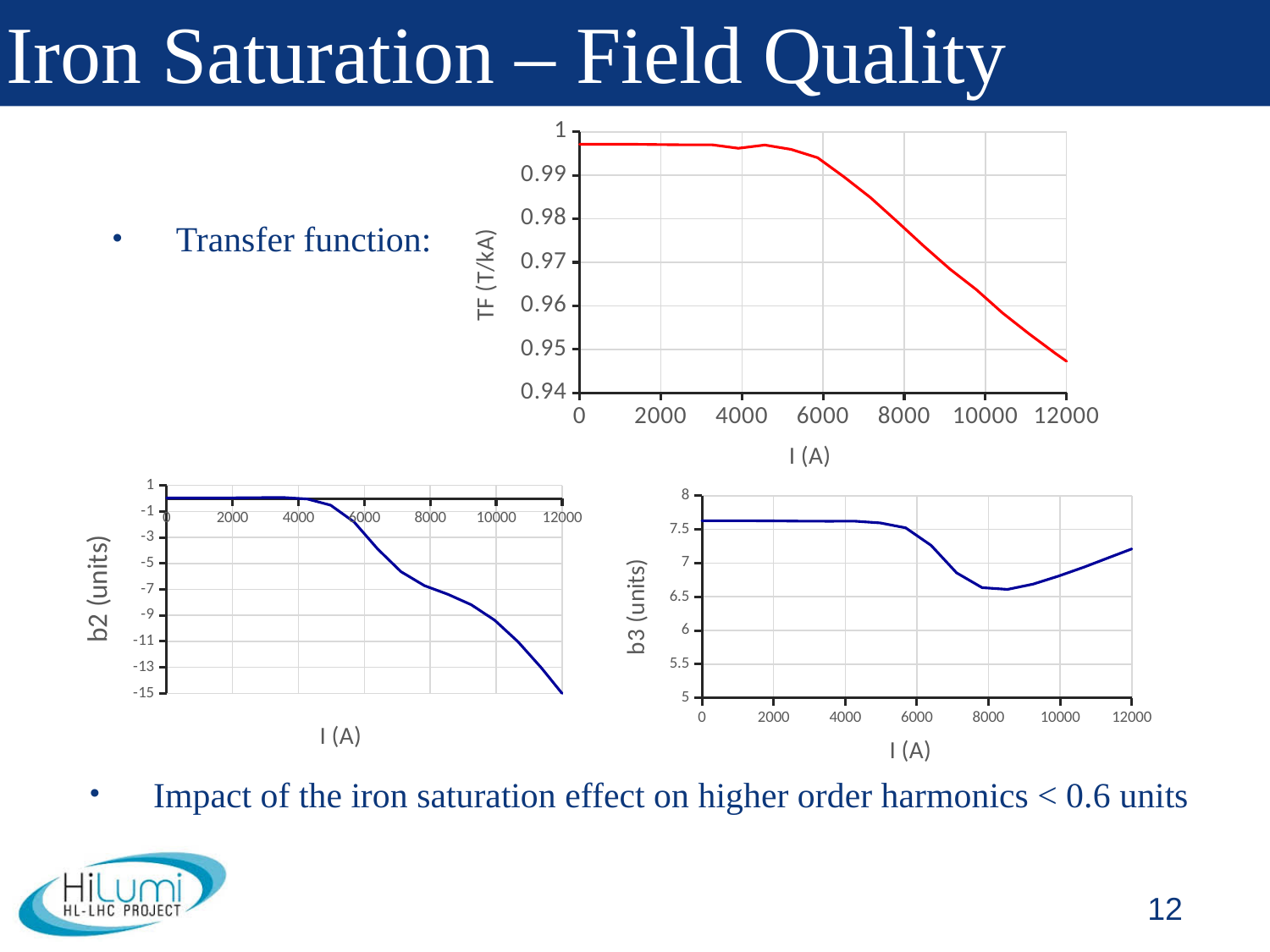
In the bottom-left chart (b2 vs I), is the value at I = 12000 greater or less than -13? less In the bottom-right chart (b3 vs I), do the values rise or fall as I increases from 8000 to 12000? rise In the bottom-left chart (b2 vs I), is the value at I = 8000 greater or less than -5? less In the top chart (TF vs I), is the value at I = 6000 greater or less than 0.99? greater What kind of chart is the top chart with y-axis TF (T/kA)? line chart How many charts are shown on the slide? 3 In the top chart (TF vs I), do the values rise or fall as I increases from 6000 to 12000? fall In the bottom-left chart (b2 vs I), do the values rise or fall as I increases? fall What is the y-axis label of the top chart? TF (T/kA)